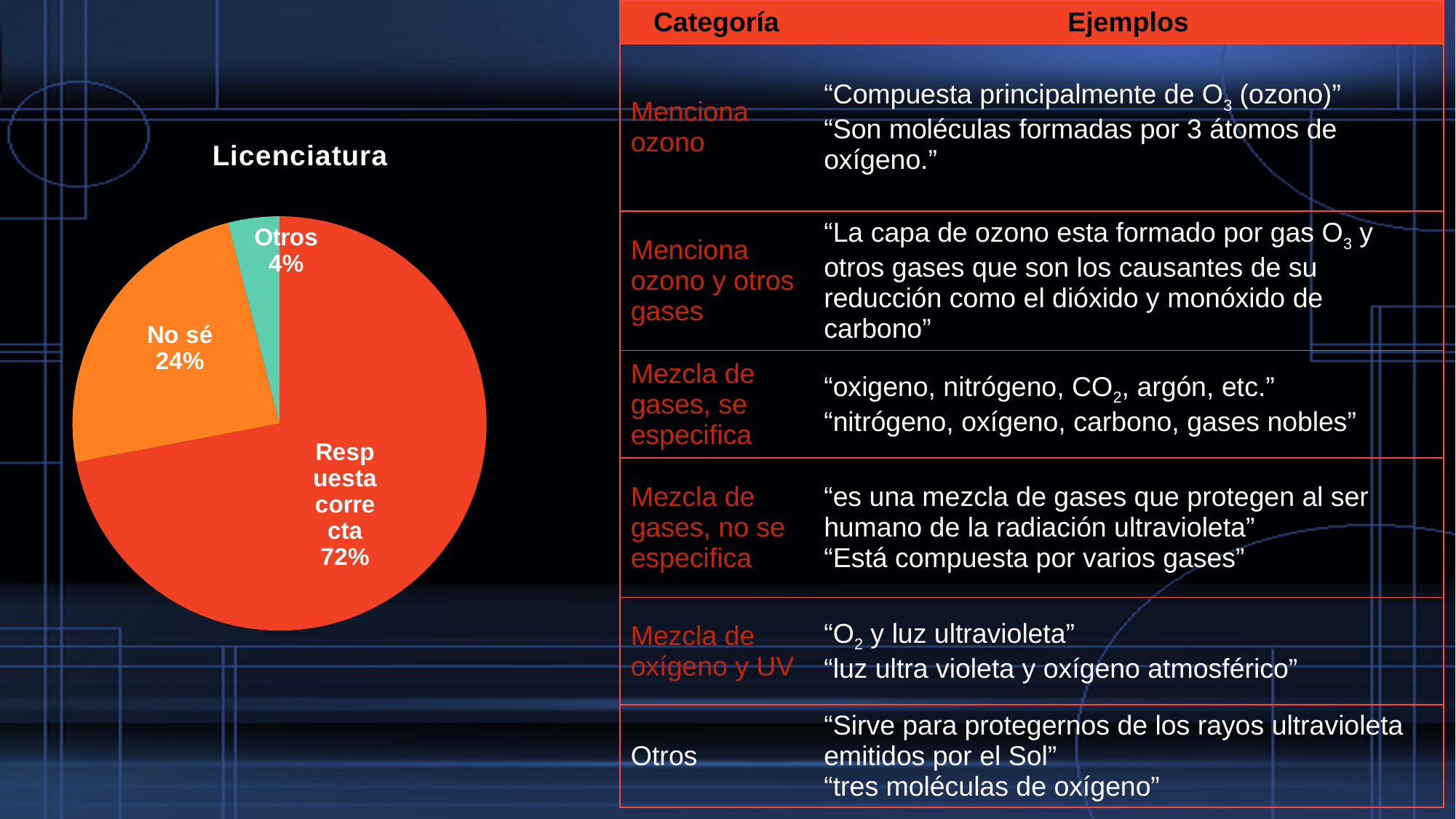
What is the title of the pie chart? Licenciatura Which slice of the pie chart is the smallest? Otros Which is larger in the pie chart, "No sé" or "Otros"? No sé What colour is the "Otros" slice of the pie chart? teal What percentage of the pie chart is labelled "Respuesta correcta"? 72% What is the difference in percentage points between the "No sé" slice and the "Otros" slice? 20 What is the difference in percentage points between the "Respuesta correcta" slice and the "No sé" slice? 48 Which slice of the pie chart is the largest? Respuesta correcta What percentage of the pie chart is labelled "Otros"? 4% How many slices does the pie chart have? 3 What percentage of the pie chart is labelled "No sé"? 24% What type of chart is shown on the slide? pie chart